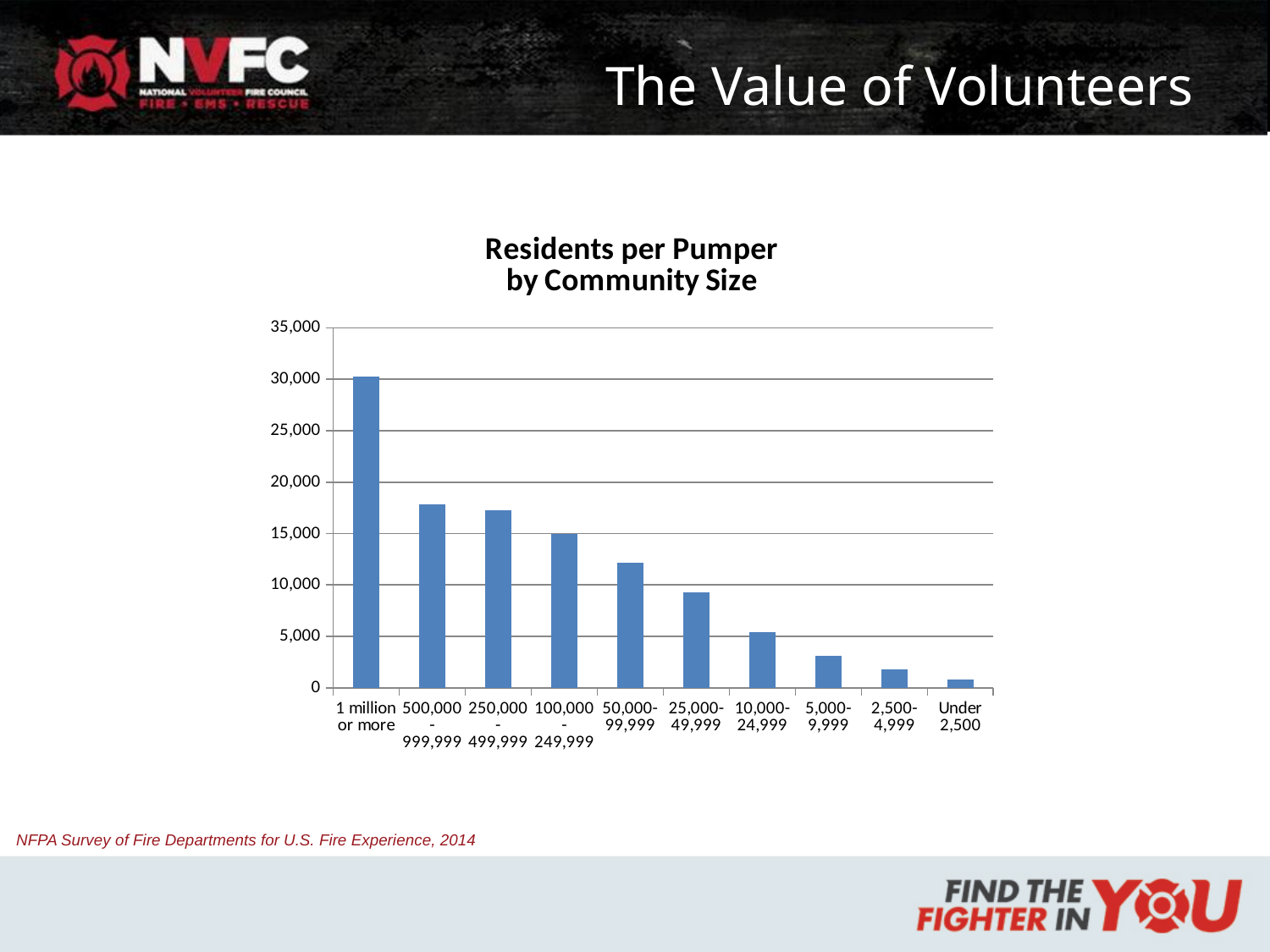
Which community size has the lowest residents per pumper? Under 2,500 What is the title of the chart? Residents per Pumper by Community Size How many community size categories are shown on the x axis? 10 Do the values rise or fall moving from left to right along the x axis? fall Is the value for communities of 50,000-99,999 greater or less than 10,000? greater What type of chart is shown on the slide? bar chart Is the value for communities of 100,000-249,999 greater or less than 20,000? less Which community size has the highest residents per pumper? 1 million or more Is the value for communities of 25,000-49,999 greater or less than 10,000? less Which has more residents per pumper: communities of 500,000-999,999 or communities of 5,000-9,999? 500,000-999,999